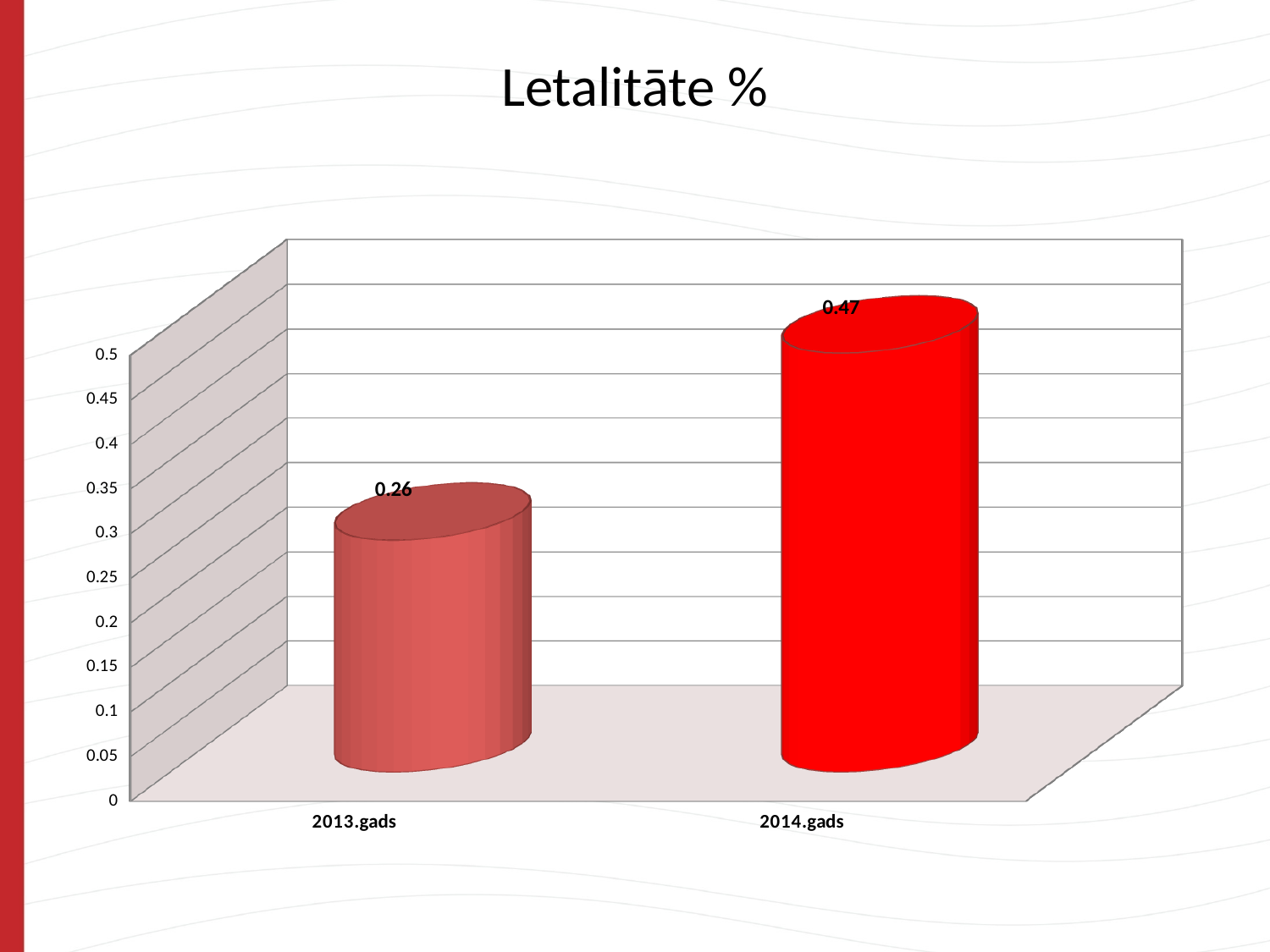
What is the title of the slide? Letalitāte % Is the value for 2013.gads greater or less than 0.3? less What is the difference between the values for 2014.gads and 2013.gads? 0.21 Which year has the lowest value? 2013.gads How many categories are shown on the x axis? 2 Do the values rise or fall from 2013.gads to 2014.gads? rise What kind of chart is shown on the slide? bar chart Is the value for 2014.gads greater or less than 0.4? greater What is the value for 2013.gads? 0.26 What is the value for 2014.gads? 0.47 Which is larger, the value for 2013.gads or the value for 2014.gads? 2014.gads Which year has the highest value? 2014.gads